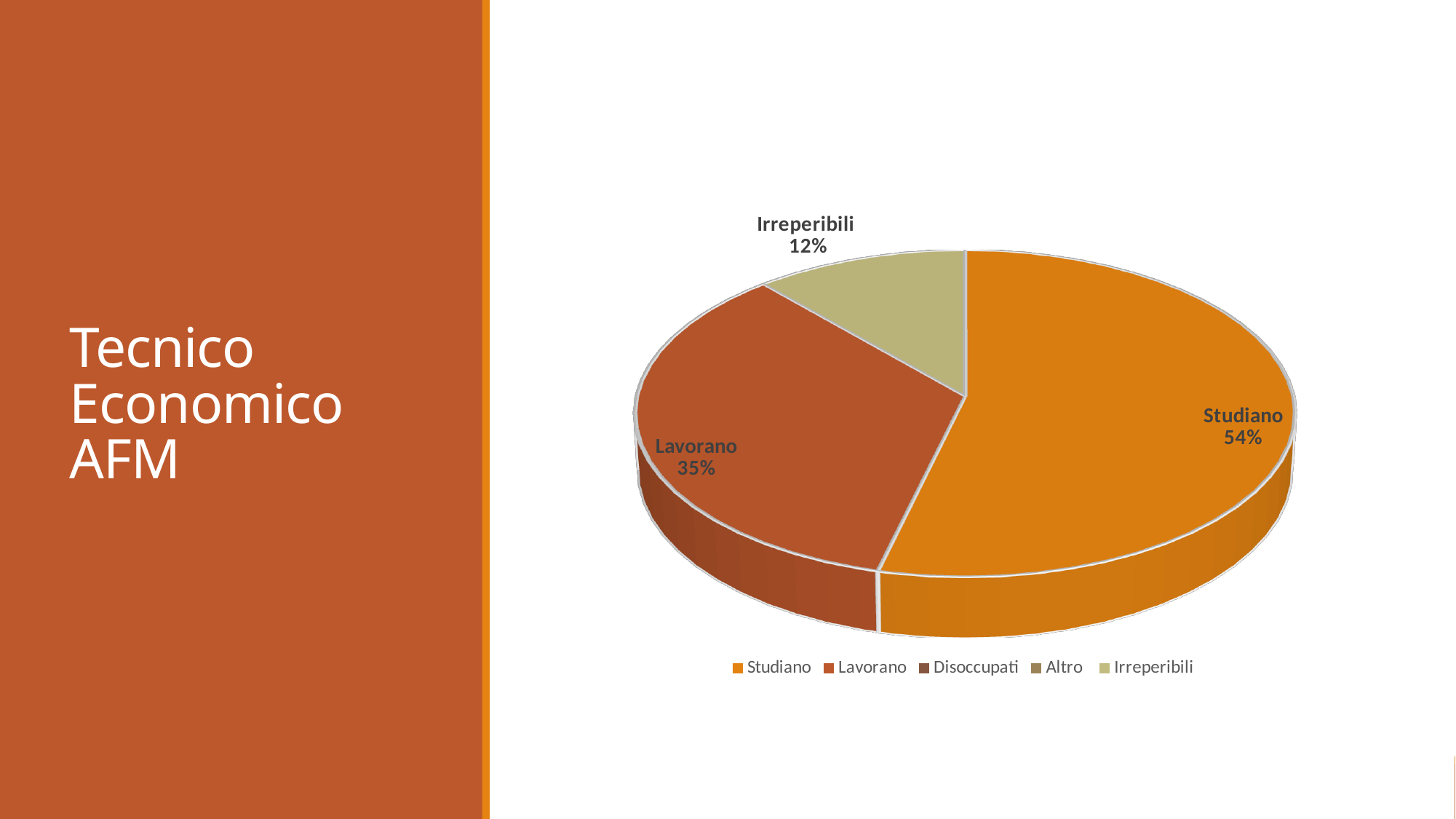
Which category has the largest slice of the pie? Studiano How many entries does the legend list? 5 How many slices with printed labels are visible in the pie? 3 What percentage of the pie chart is labelled Studiano? 54% Among the slices with printed labels, which is the smallest? Irreperibili What share of the pie does the Studiano slice represent? 54% Which slice is larger, Lavorano or Irreperibili? Lavorano What is the title text shown on the left side of the slide? Tecnico Economico AFM What is the value shown for Irreperibili? 12% What percentage does the Lavorano slice show? 35% What type of chart is shown on the slide? Pie chart By how many percentage points does Studiano exceed Lavorano? 19 percentage points